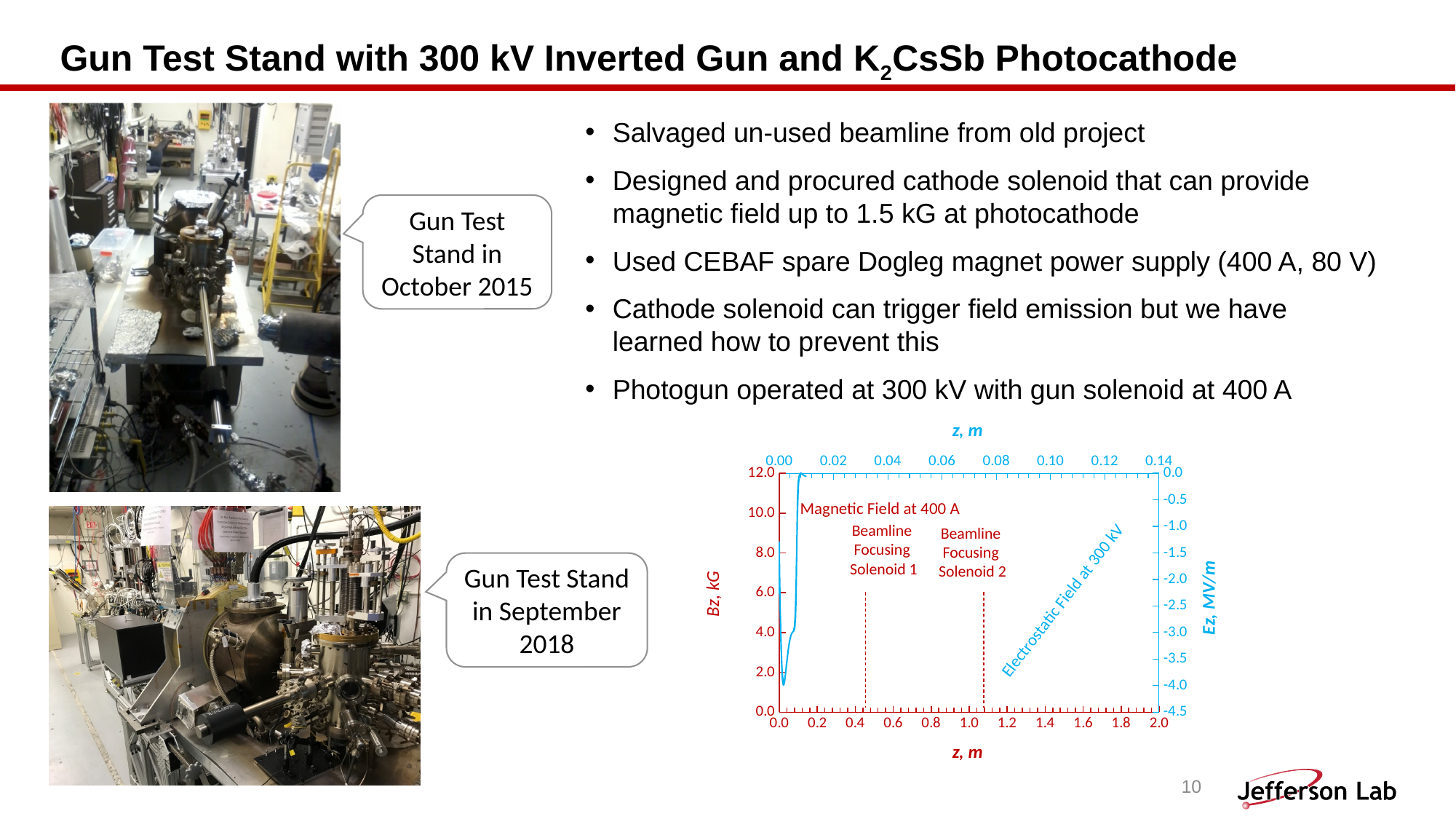
Is the Electrostatic Field at 300 kV at z = 0.00 m greater or less than -2.0 MV/m? less Is the z position of Beamline Focusing Solenoid 1 greater or less than 0.6 m? less How many field curves are labeled on the chart? 2 Is the z position of Beamline Focusing Solenoid 2 greater or less than 0.8 m? greater What kind of chart is shown on the slide? line chart How many beamline focusing solenoids are marked with dashed lines on the chart? 2 What is the label of the right vertical axis of the chart? Ez, MV/m Does the Electrostatic Field at 300 kV curve rise or fall toward zero as z increases from the cathode? rises Which is located at a larger z position, Beamline Focusing Solenoid 1 or Beamline Focusing Solenoid 2? Beamline Focusing Solenoid 2 What is the label of the left vertical axis of the chart? Bz, kG